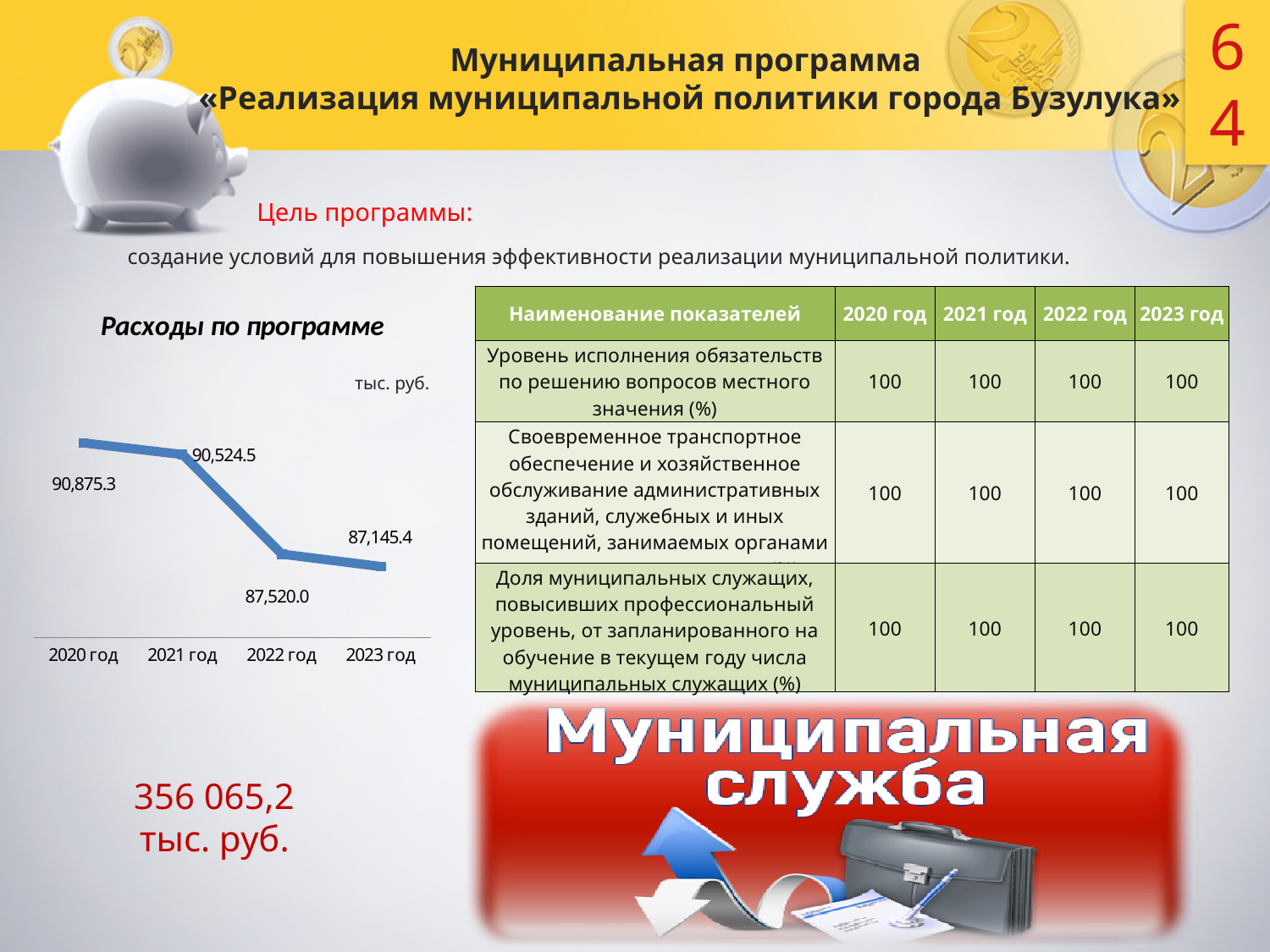
In the chart "Расходы по программе", what is the value for 2023 год? 87,145.4 In the chart "Расходы по программе", which is larger: the value for 2021 год or the value for 2022 год? 2021 год In the chart "Расходы по программе", which year has the highest value? 2020 год How many years are plotted in the chart "Расходы по программе"? 4 In the chart "Расходы по программе", what is the difference between the values for 2021 год and 2022 год? 3,004.5 In the chart "Расходы по программе", do the values rise or fall from 2020 год to 2023 год? fall What type of chart is "Расходы по программе"? line chart In the chart "Расходы по программе", what is the value for 2022 год? 87,520.0 In the chart "Расходы по программе", what is the difference between the values for 2020 год and 2023 год? 3,729.9 In the chart "Расходы по программе", which year has the lowest value? 2023 год In the chart "Расходы по программе", what is the value for 2020 год? 90,875.3 In the chart "Расходы по программе", what is the value for 2021 год? 90,524.5